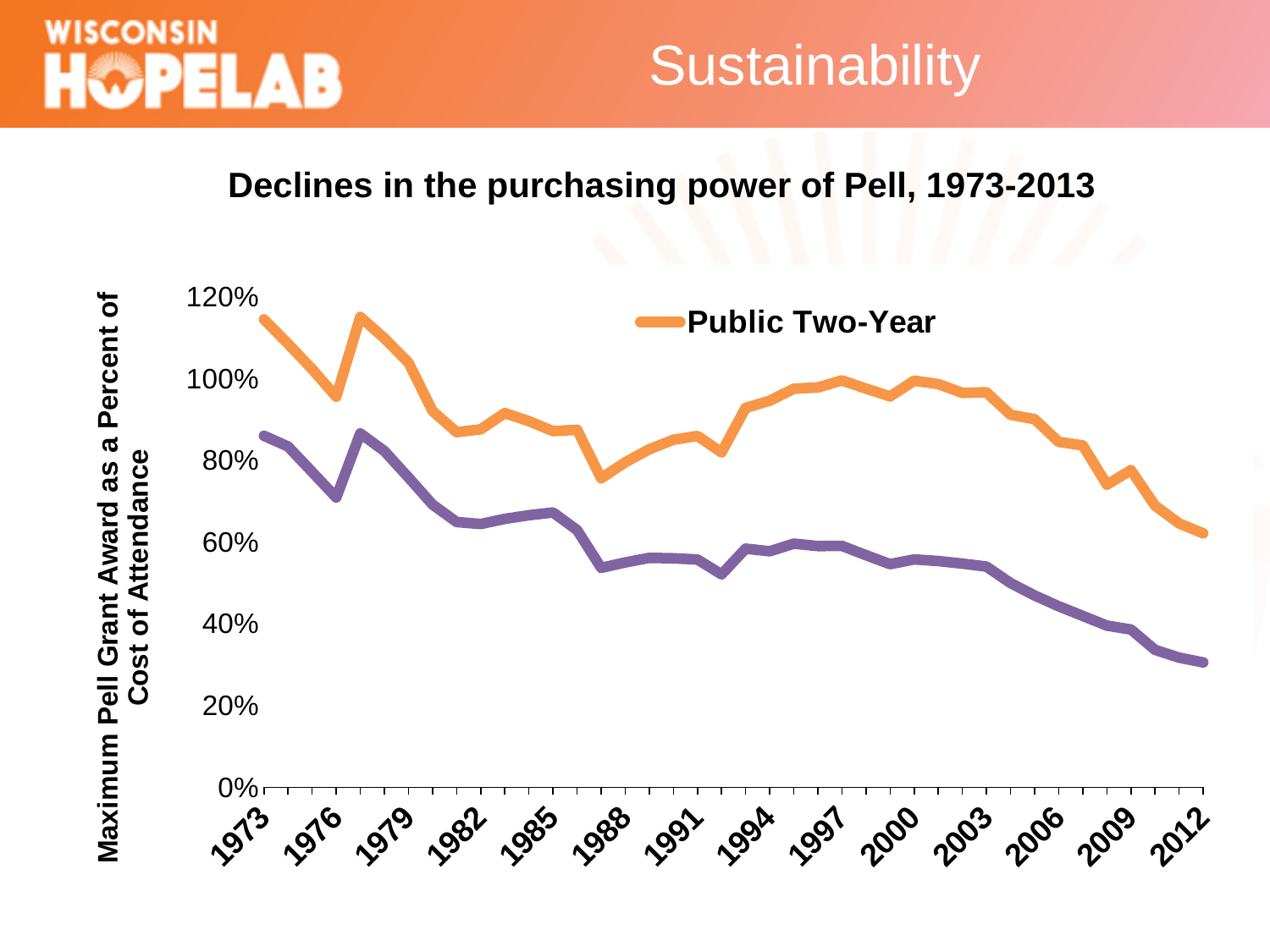
How many year labels are shown along the x axis? 14 Is the Public Two-Year value in 2003 greater or less than 80%? greater What is the title of the chart? Declines in the purchasing power of Pell, 1973-2013 Which is larger for Public Two-Year: the value in 1973 or the value in 2012? 1973 How many series does the chart's legend list? 1 Is the Public Two-Year value in 2012 greater or less than 80%? less What type of chart is shown on the slide? line chart Overall, does the Public Two-Year line rise or fall from 1973 to 2012? fall Is the Public Two-Year value in 1973 greater or less than 100%? greater What series name appears in the chart's legend? Public Two-Year